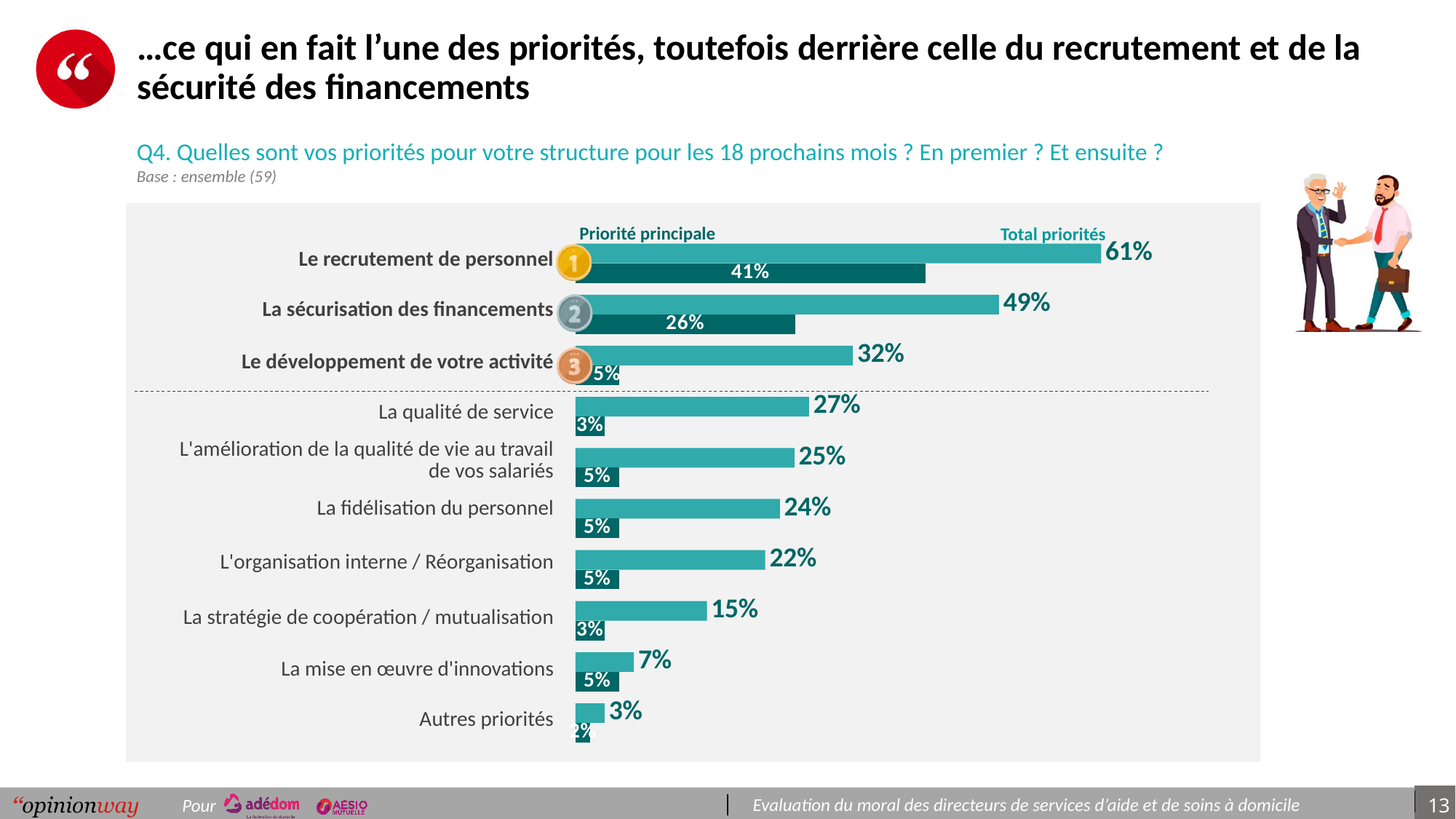
What is the 'Total priorités' value for 'Le recrutement de personnel'? 61% What is the 'Priorité principale' value for 'La sécurisation des financements'? 26% How many categories are shown in the chart? 10 Which category has the highest 'Total priorités' value? Le recrutement de personnel How many series does the chart show? 2 Which category has the lowest 'Total priorités' value? Autres priorités Which has a larger 'Total priorités' value: 'La qualité de service' or 'L'organisation interne / Réorganisation'? La qualité de service What is the difference between the 'Total priorités' values for 'Le recrutement de personnel' and 'La sécurisation des financements'? 12% What is the difference between the 'Total priorités' and 'Priorité principale' values for 'Le recrutement de personnel'? 20% What kind of chart is shown on the slide? Bar chart What is the 'Priorité principale' value for 'Le développement de votre activité'? 5% What is the 'Total priorités' value for 'La fidélisation du personnel'? 24%